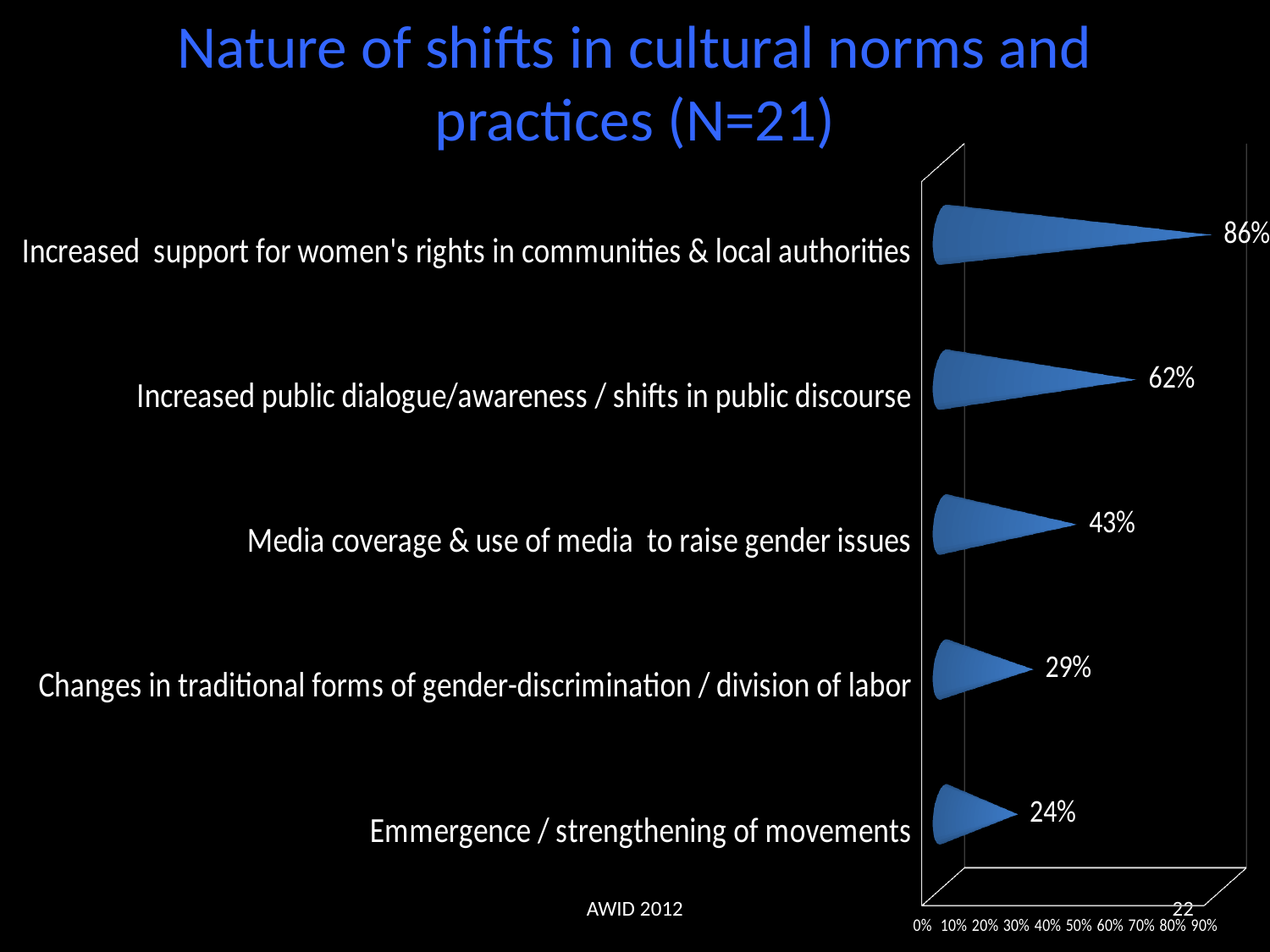
What is the value for 'Emmergence / strengthening of movements'? 24% What kind of chart is shown on the slide? Bar chart What is the value for 'Increased support for women's rights in communities & local authorities'? 86% What is the value for 'Increased public dialogue/awareness / shifts in public discourse'? 62% What is the value for 'Media coverage & use of media to raise gender issues'? 43% Which category has the lowest value? Emmergence / strengthening of movements What is the title of the chart? Nature of shifts in cultural norms and practices (N=21) What is the value for 'Changes in traditional forms of gender-discrimination / division of labor'? 29% How many categories are shown in the chart? 5 What is the difference between the values for 'Increased support for women's rights in communities & local authorities' and 'Increased public dialogue/awareness / shifts in public discourse'? 24% Which category has the highest value? Increased support for women's rights in communities & local authorities Which is larger: the value for 'Media coverage & use of media to raise gender issues' or the value for 'Changes in traditional forms of gender-discrimination / division of labor'? Media coverage & use of media to raise gender issues